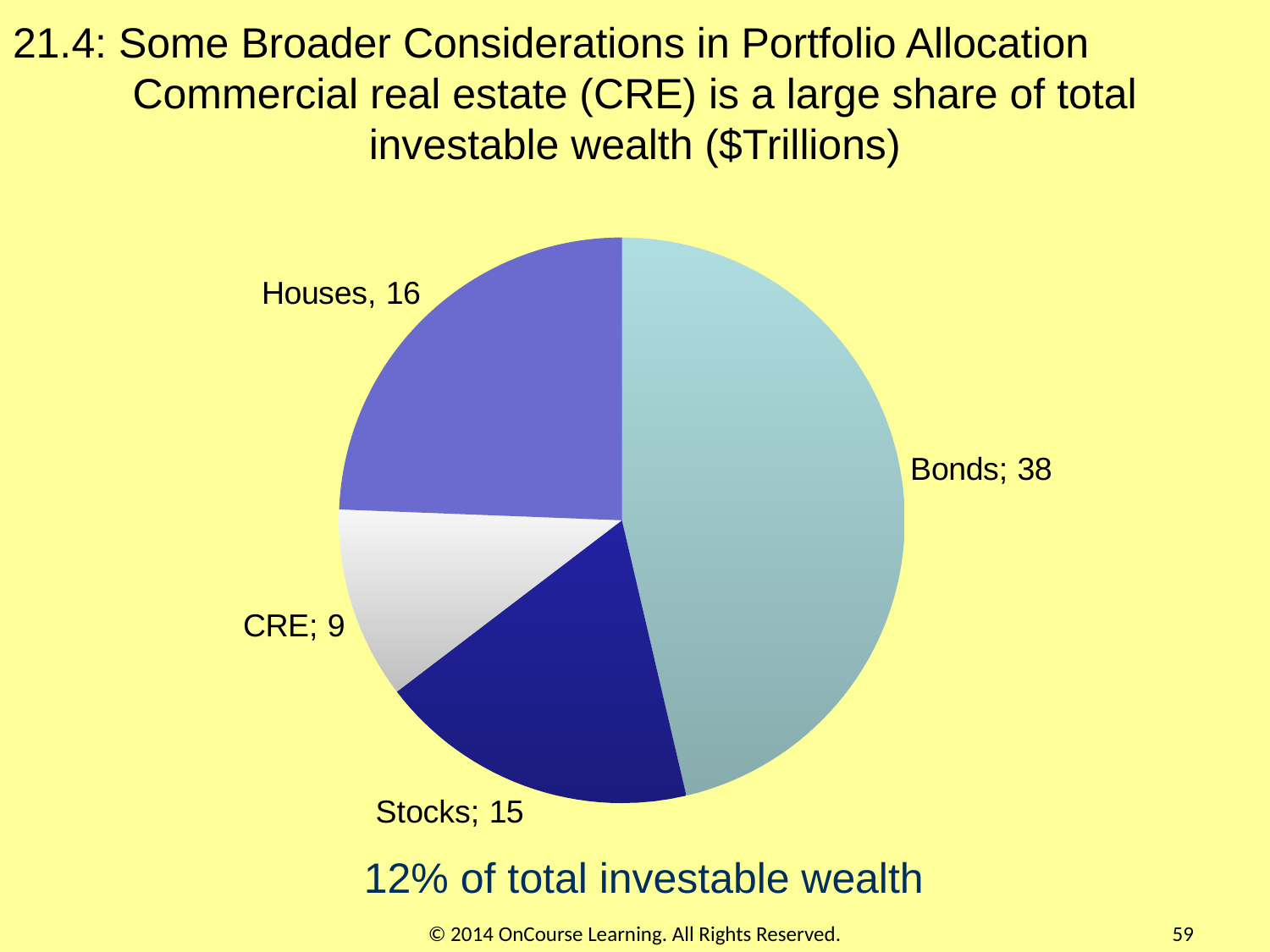
Which is larger, the value for Bonds or the value for Stocks? Bonds What is the difference between the values for Stocks and CRE? 6 According to the slide, what share of total investable wealth is CRE? 12% What is the value for Bonds? 38 How many categories are shown in the pie chart? 4 What type of chart is shown on the slide? pie chart What is the value for Stocks? 15 What is the value for CRE? 9 What is the difference between the values for Bonds and Houses? 22 Which category has the largest slice of the pie? Bonds What is the value for Houses? 16 Which category has the smallest slice of the pie? CRE